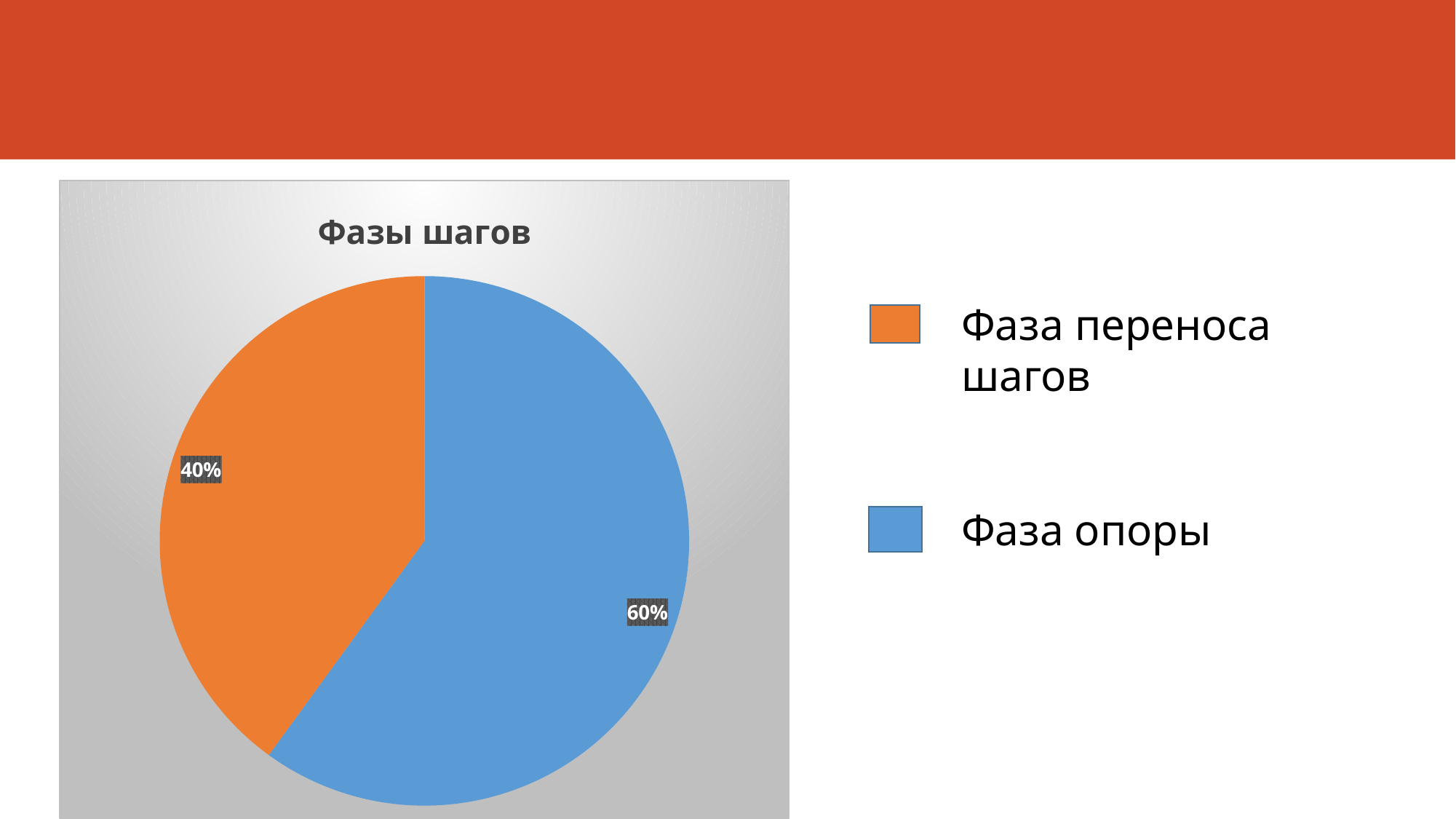
What type of chart is shown on the slide? pie chart What is the title of the chart? Фазы шагов Which phase has the larger share of the pie? Фаза опоры What is the difference in percentage points between Фаза опоры and Фаза переноса шагов? 20% What share of the pie does Фаза переноса шагов take? 40% What colour is the slice for Фаза опоры? blue What percentage does the orange slice (Фаза переноса шагов) show? 40% Which is larger: the share for Фаза переноса шагов or the share for Фаза опоры? Фаза опоры What percentage does the blue slice (Фаза опоры) show? 60% Which phase has the smaller share of the pie? Фаза переноса шагов How many slices does the pie chart have? 2